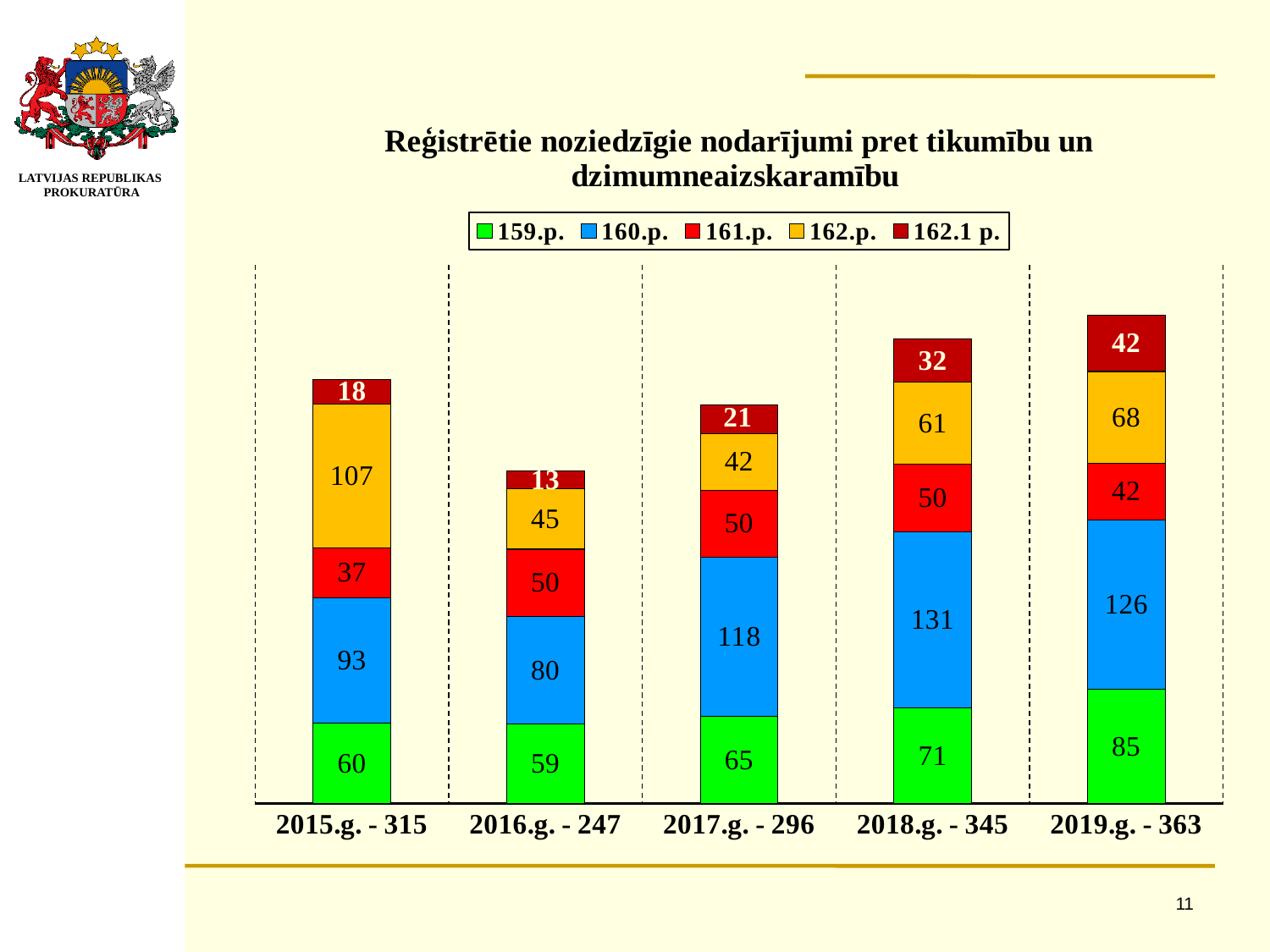
How many years (categories) are shown on the x axis? 5 Which is larger: the 161.p. value in 2015.g. or in 2017.g.? 2017.g. What is the total of the stacked bar for 2019.g.? 363 Which year has the lowest total? 2016.g. What type of chart is shown on the slide? stacked bar chart What is the difference between the 162.p. values in 2015.g. and 2016.g.? 62 What is the value for 160.p. in 2018.g.? 131 How many series does the legend list? 5 Which year has the highest value for 159.p.? 2019.g. What is the value for 162.p. in 2015.g.? 107 What is the title of the chart? Reģistrētie noziedzīgie nodarījumi pret tikumību un dzimumneaizskaramību What is the value for 162.1 p. in 2016.g.? 13